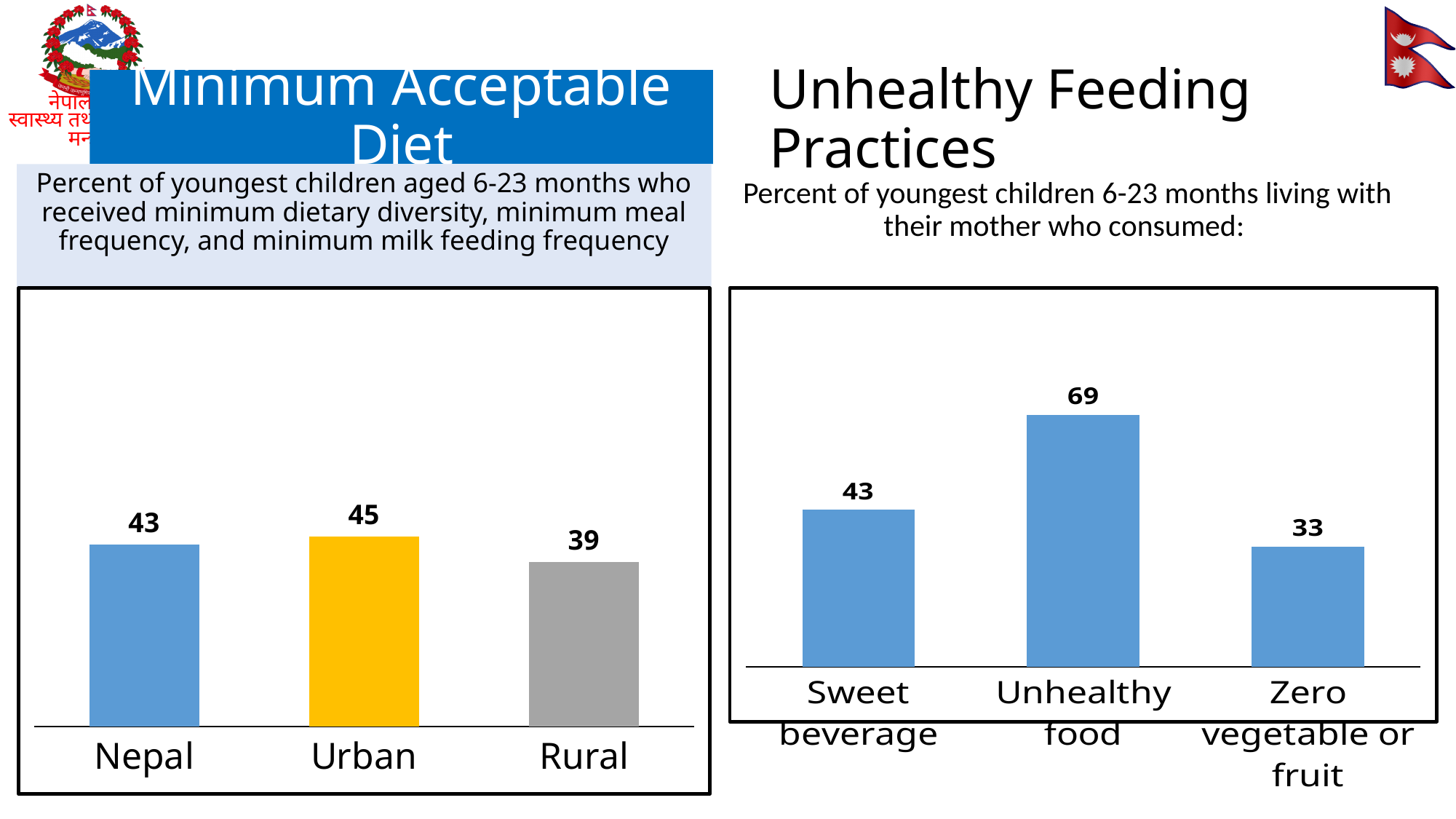
In the Minimum Acceptable Diet chart, which category has the lowest value? Rural What kind of chart is the Unhealthy Feeding Practices chart? Bar chart In the Minimum Acceptable Diet chart, what is the difference between the Urban and Rural values? 6 In the Unhealthy Feeding Practices chart, which is larger, Sweet beverage or Zero vegetable or fruit? Sweet beverage In the Minimum Acceptable Diet chart, which bar is coloured yellow? Urban In the Unhealthy Feeding Practices chart, what is the difference between the Unhealthy food and Sweet beverage values? 26 In the Unhealthy Feeding Practices chart, which category has the highest value? Unhealthy food In the Minimum Acceptable Diet chart, what is the value for Urban? 45 In the Unhealthy Feeding Practices chart, what is the value for Unhealthy food? 69 In the Minimum Acceptable Diet chart, how many categories are shown? 3 In the Unhealthy Feeding Practices chart, what is the value for Zero vegetable or fruit? 33 In the Minimum Acceptable Diet chart, what is the value for Rural? 39